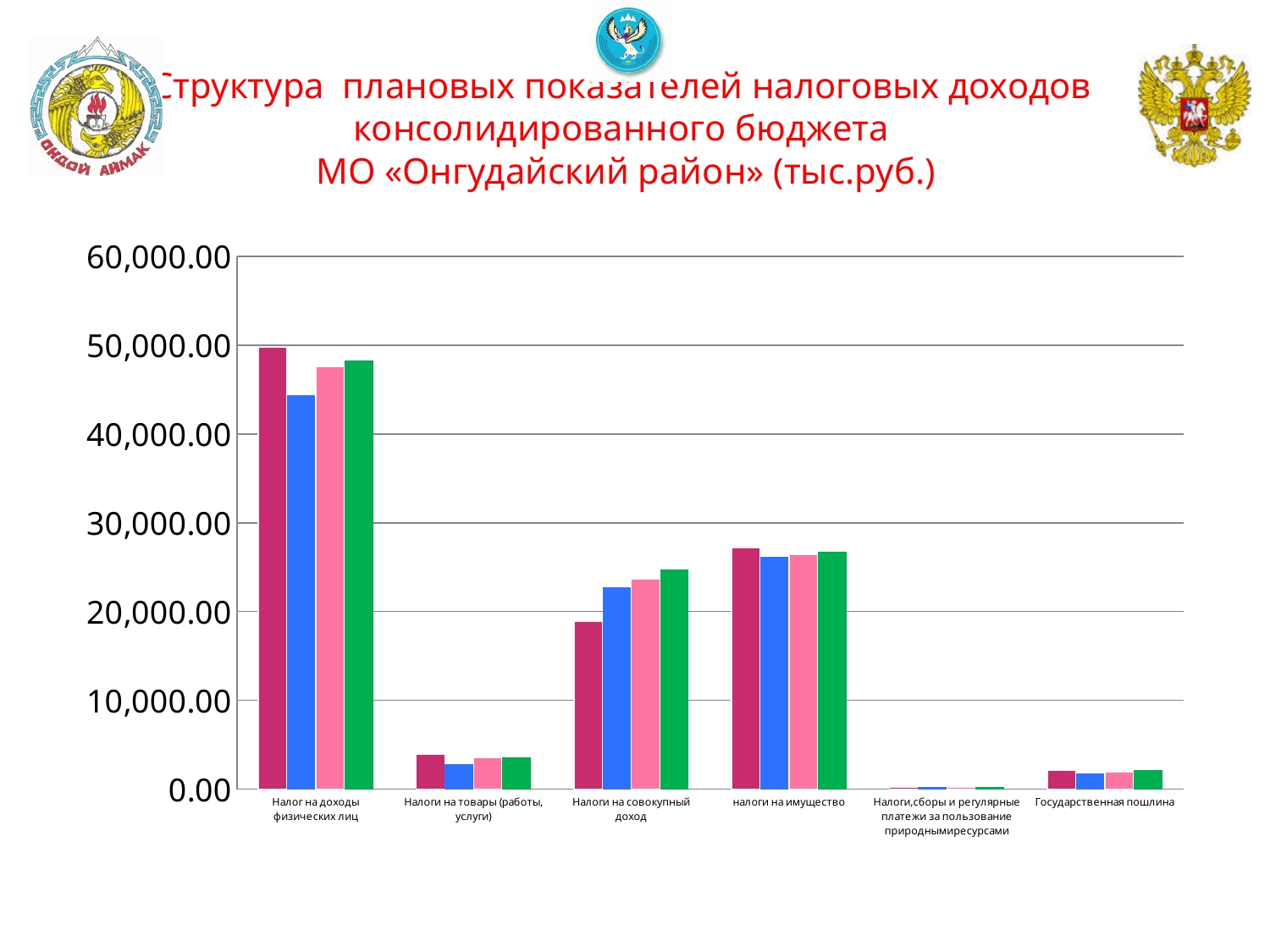
Is the value of the green bar for Налоги на совокупный доход greater or less than 20,000.00? greater Is the value of the crimson (first) bar for Налоги на совокупный доход greater or less than 20,000.00? less What is the unit of measurement given in the chart title? тыс.руб. For Налог на доходы физических лиц, which bar is taller: the crimson (first) bar or the blue (second) bar? the crimson (first) bar How many categories are shown along the x axis of the chart? 6 Which category has the highest bars in the chart? Налог на доходы физических лиц What kind of chart is shown on the slide? bar chart Which category has larger bars: налоги на имущество or Налоги на совокупный доход? налоги на имущество How many bars are plotted for each category in the chart? 4 Is the value of the blue bar for Налог на доходы физических лиц greater or less than 40,000.00? greater Which category has the lowest bars in the chart? Налоги,сборы и регулярные платежи за пользование природными ресурсами